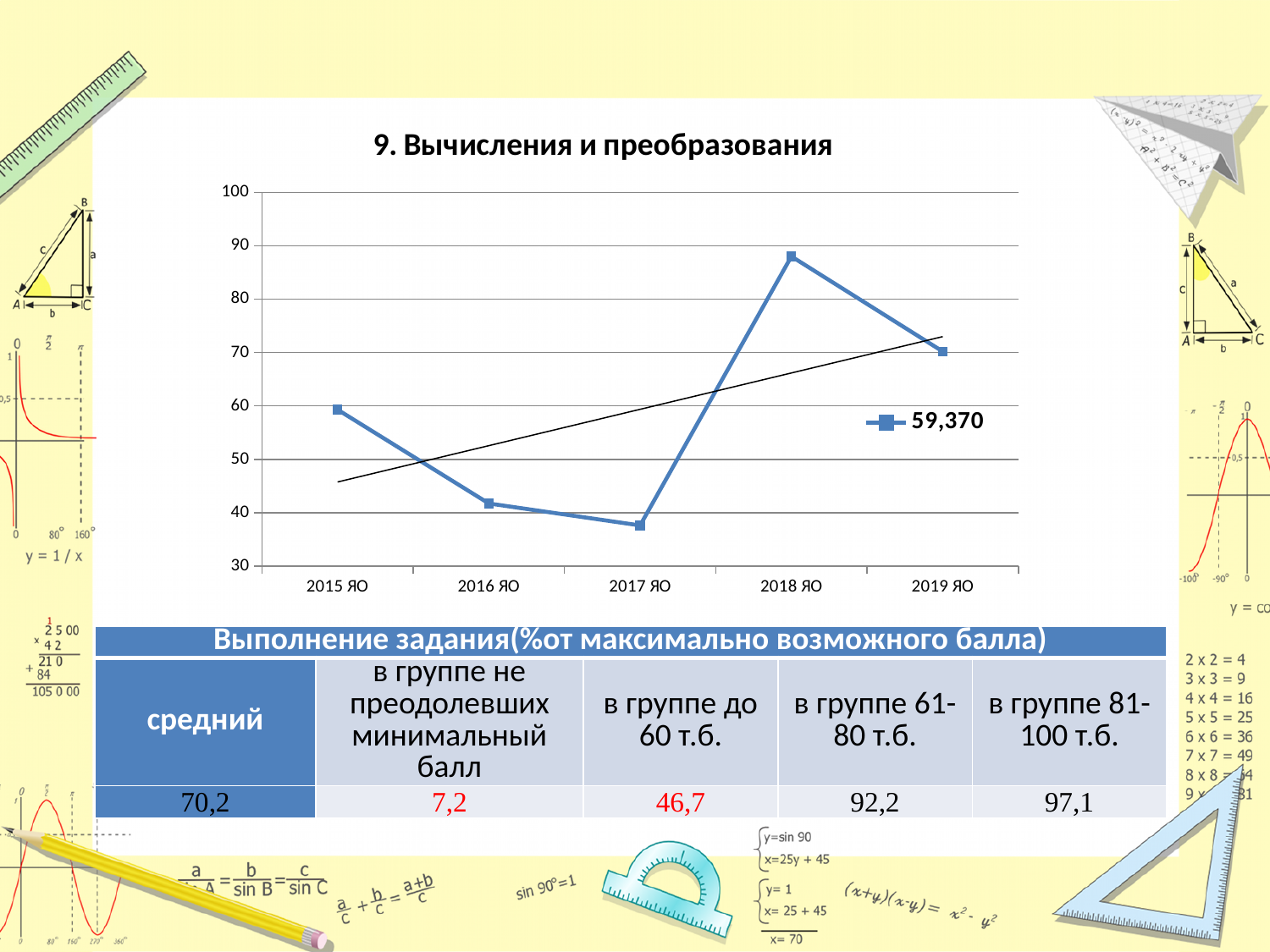
Which category has the lowest value? 2017 ЯО Which is larger, the value for 2019 ЯО or the value for 2016 ЯО? 2019 ЯО Is the value for 2015 ЯО greater or less than 50? greater Does the value fall or rise from 2017 ЯО to 2018 ЯО? rise Is the value for 2017 ЯО greater or less than 40? less How many data points are plotted on the line? 5 Which category has the highest value? 2018 ЯО What is the legend entry shown for the plotted series? 59,370 Is the value for 2018 ЯО greater or less than 80? greater What is the title of the chart? 9. Вычисления и преобразования How many series does the legend list? 1 What kind of chart is shown on the slide? line chart